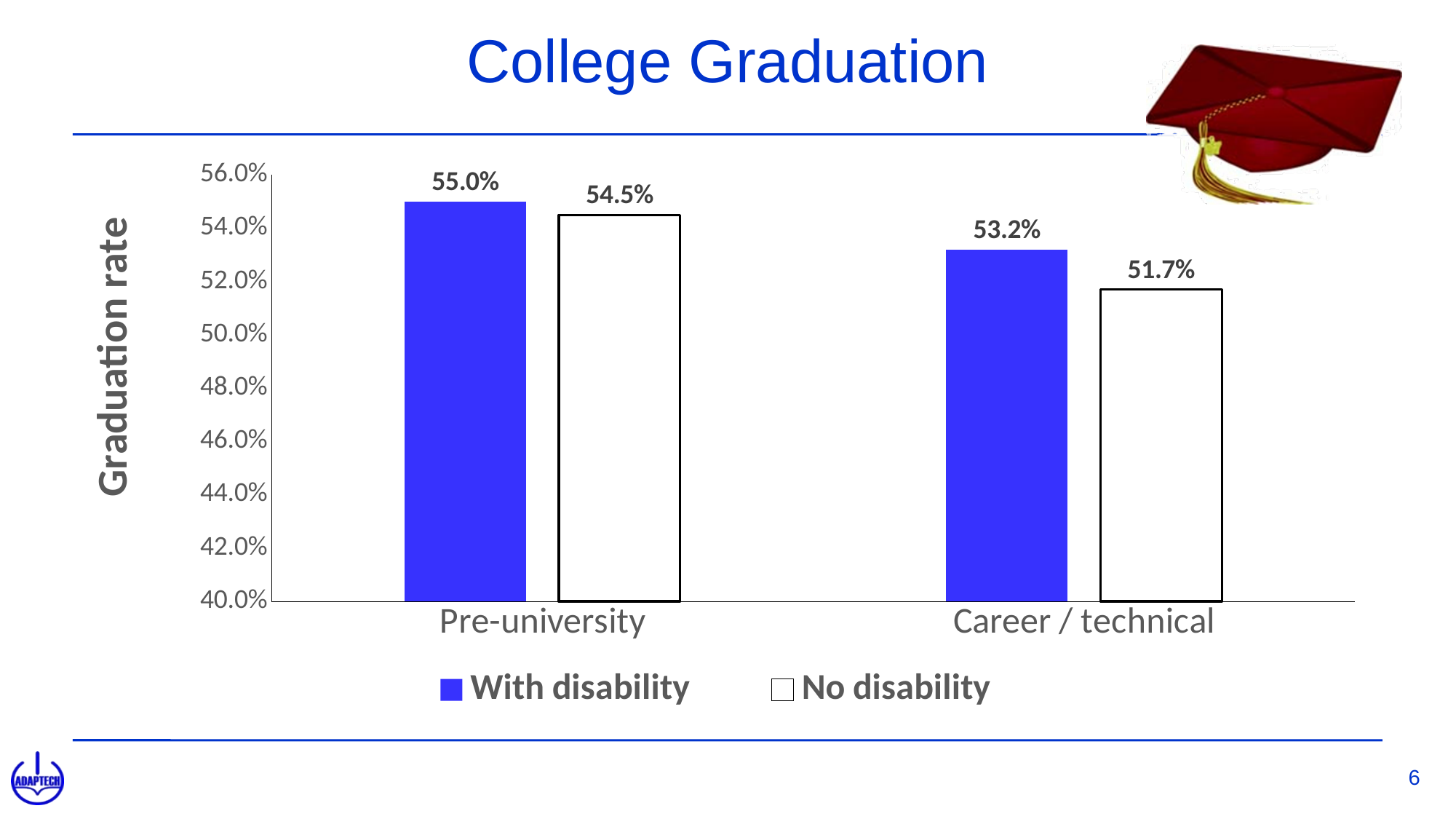
Which is larger: the No disability rate for Pre-university or the With disability rate for Career / technical? No disability rate for Pre-university What type of chart is shown on the slide? Bar chart How many series does the legend list? 2 What is the difference between the Pre-university and Career / technical graduation rates for students with disability? 1.8% What is the graduation rate for students with no disability in the Career / technical category? 51.7% What is the graduation rate for students with disability in the Pre-university category? 55.0% Which bar has the highest graduation rate on the chart? With disability, Pre-university How many categories are shown on the x axis? 2 Which bar has the lowest graduation rate on the chart? No disability, Career / technical What is the graduation rate for students with disability in the Career / technical category? 53.2% What is the difference between the With disability and No disability graduation rates in the Career / technical category? 1.5% What is the graduation rate for students with no disability in the Pre-university category? 54.5%